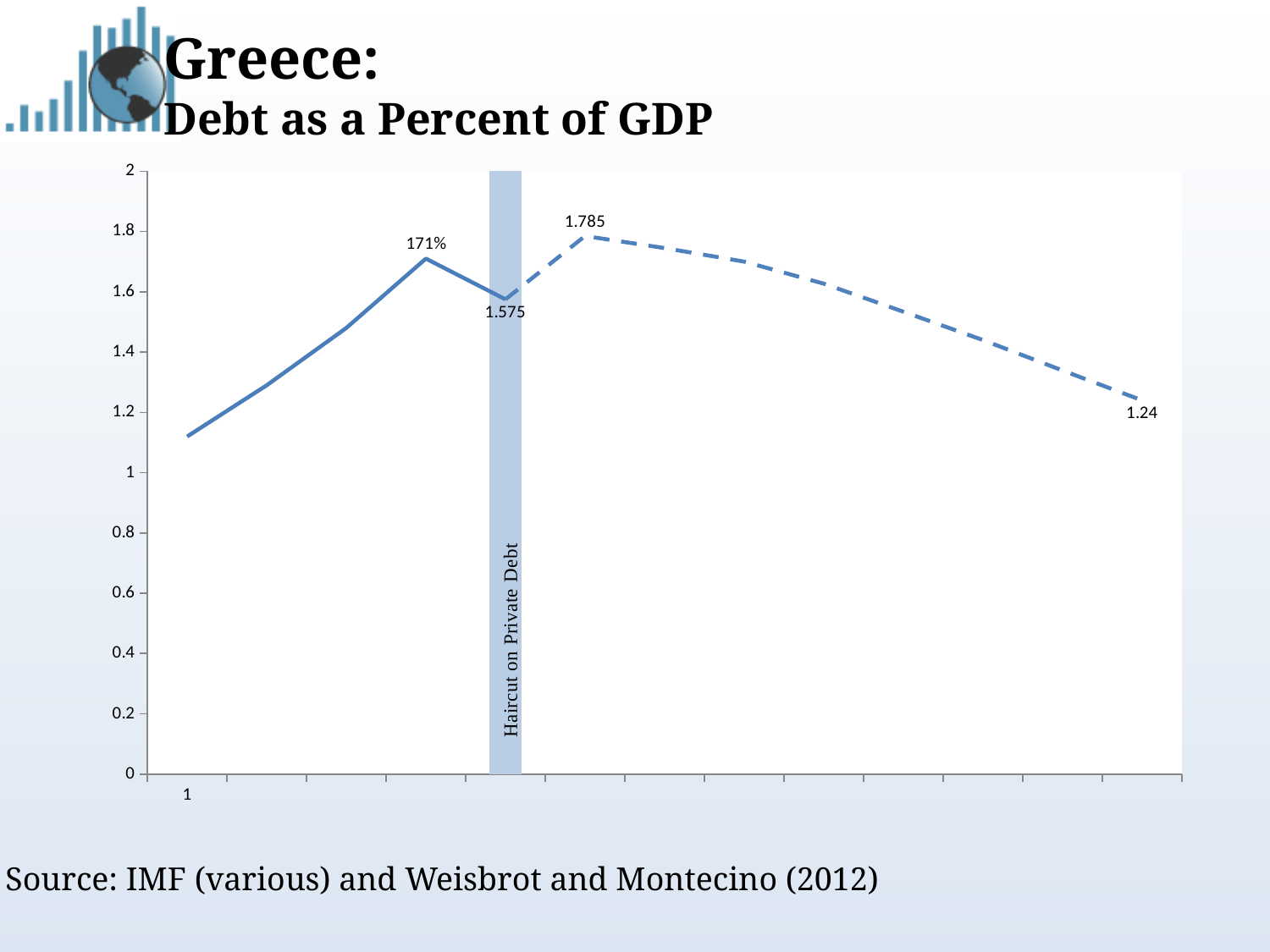
Which labeled value on the chart is the lowest? 1.24 Is the value of the first point on the left of the line greater or less than 1.2? less Which is larger: the value labeled 1.575 in the shaded band or the value labeled 1.785 just after it? 1.785 What value is labeled at the point inside the shaded 'Haircut on Private Debt' band? 1.575 What value is labeled at the peak of the solid line? 171% After the point labeled 1.785, does the dashed line rise or fall toward the right? fall What is the label written on the shaded vertical band in the chart? Haircut on Private Debt What is the difference between the labeled values 1.785 and 1.575? 0.21 What value is labeled at the highest point of the dashed line? 1.785 What value is labeled at the final point on the right end of the dashed line? 1.24 What is the difference between the labeled values 1.785 and 1.24? 0.545 What kind of chart is shown on the slide? line chart